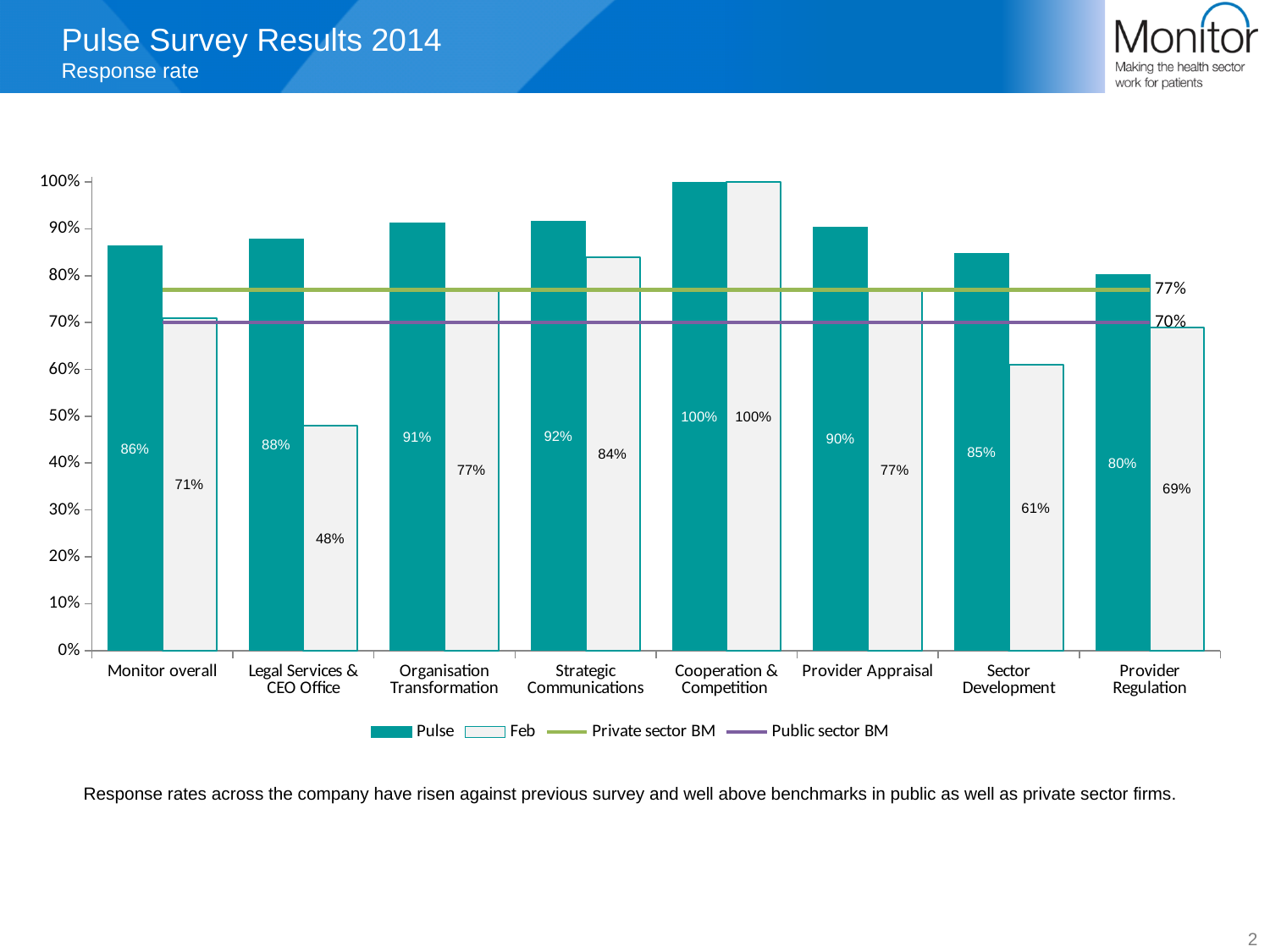
How many series does the legend list? 4 What is the Public sector BM value shown on the chart? 70% Which category has the lowest Feb response rate? Legal Services & CEO Office What is the Pulse response rate for Organisation Transformation? 91% What kind of chart is shown on the slide? Combination bar and line chart Which is larger, the Feb response rate for Strategic Communications or the Feb response rate for Provider Appraisal? Strategic Communications What is the Private sector BM value shown on the chart? 77% Which category has the highest Pulse response rate? Cooperation & Competition What is the difference between the Pulse and Feb response rates for Sector Development? 24% How many categories are shown on the x axis? 8 What is the Pulse response rate for Provider Regulation? 80% What is the Feb response rate for Legal Services & CEO Office? 48%